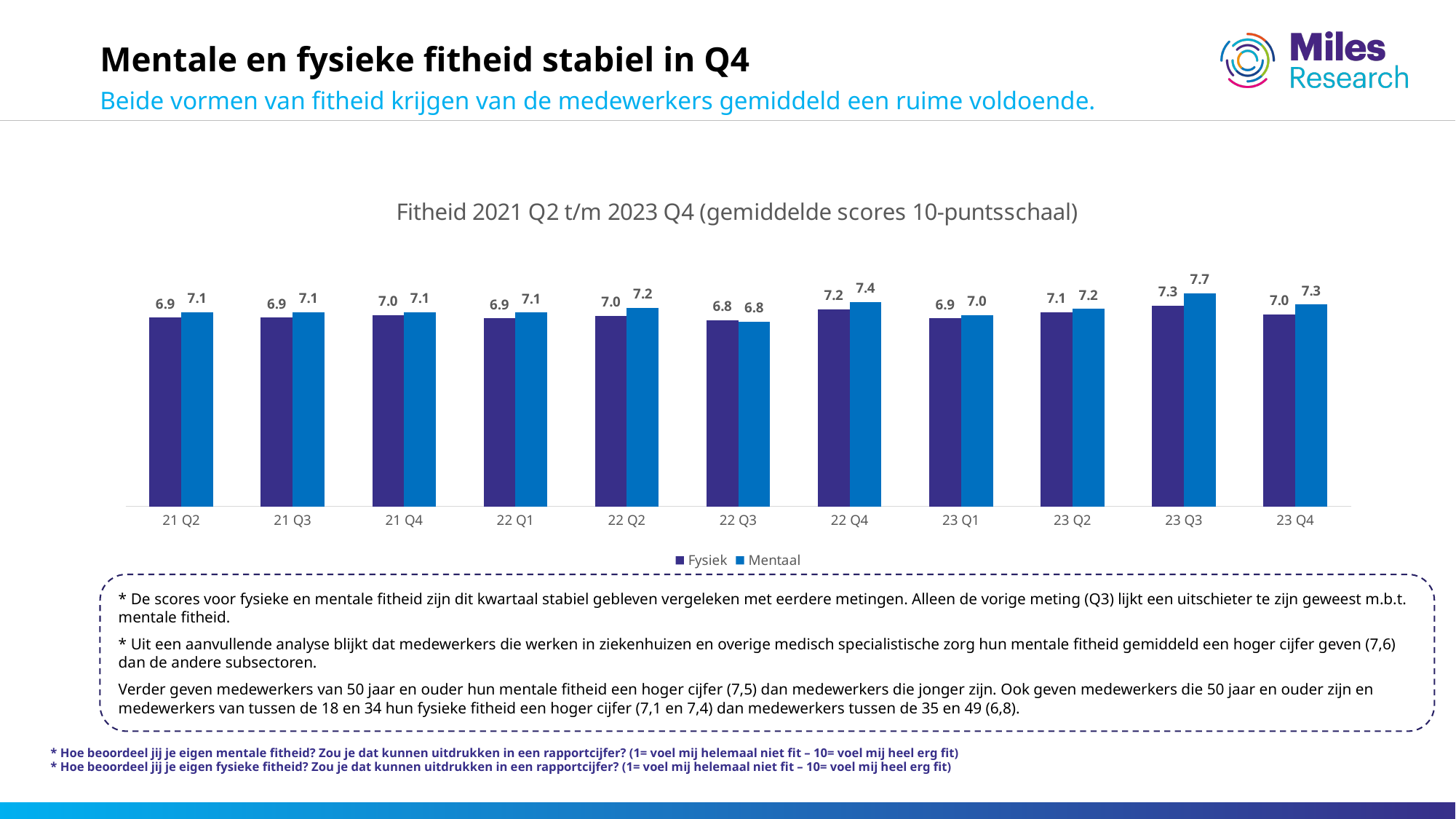
In which quarter is the Mentaal score highest? 23 Q3 What is the Mentaal value for 23 Q4? 7.3 What kind of chart is shown on the slide? Bar chart In which quarter is the Mentaal score lowest? 22 Q3 What is the Mentaal value for 23 Q3? 7.7 How many series does the legend list? 2 How many quarters are shown on the x axis? 11 In which quarter is the Fysiek score highest? 23 Q3 What is the difference between the Mentaal and Fysiek scores in 23 Q3? 0.4 What is the Fysiek value for 22 Q4? 7.2 What is the title of the chart? Fitheid 2021 Q2 t/m 2023 Q4 (gemiddelde scores 10-puntsschaal) Which is larger in 23 Q4, the Fysiek score or the Mentaal score? Mentaal